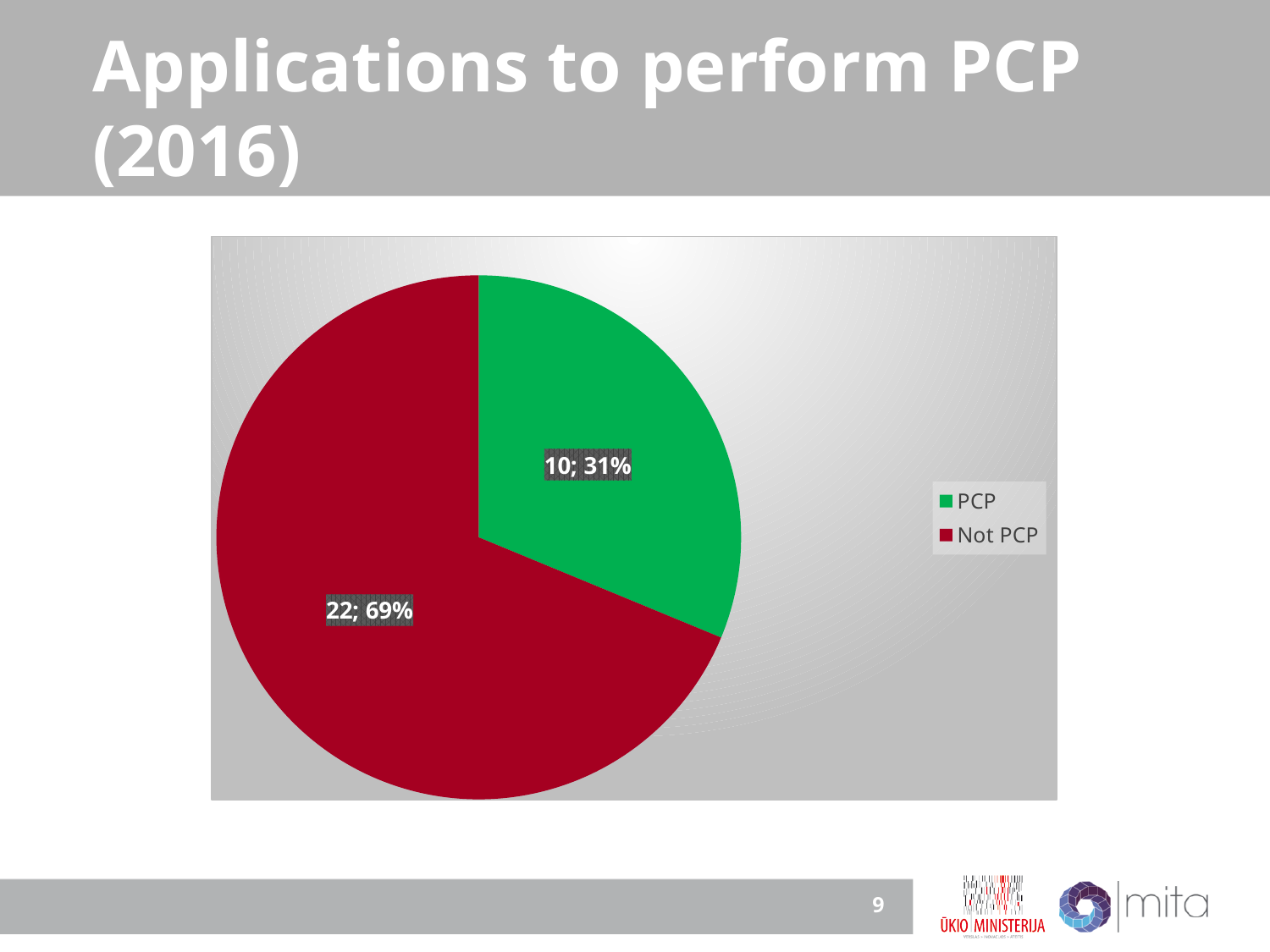
How many categories does the legend list? 2 What is the title of the slide containing the chart? Applications to perform PCP (2016) Which category has the smallest slice of the pie? PCP How many applications are labelled Not PCP? 22 What percentage share of the pie is Not PCP? 69% How many applications are labelled PCP? 10 What kind of chart is shown on the slide? pie chart What is the total number of applications shown in the pie chart? 32 What percentage share of the pie is PCP? 31% Which category has the larger slice, PCP or Not PCP? Not PCP What colour is the PCP slice? green What is the difference in the number of applications between Not PCP and PCP? 12